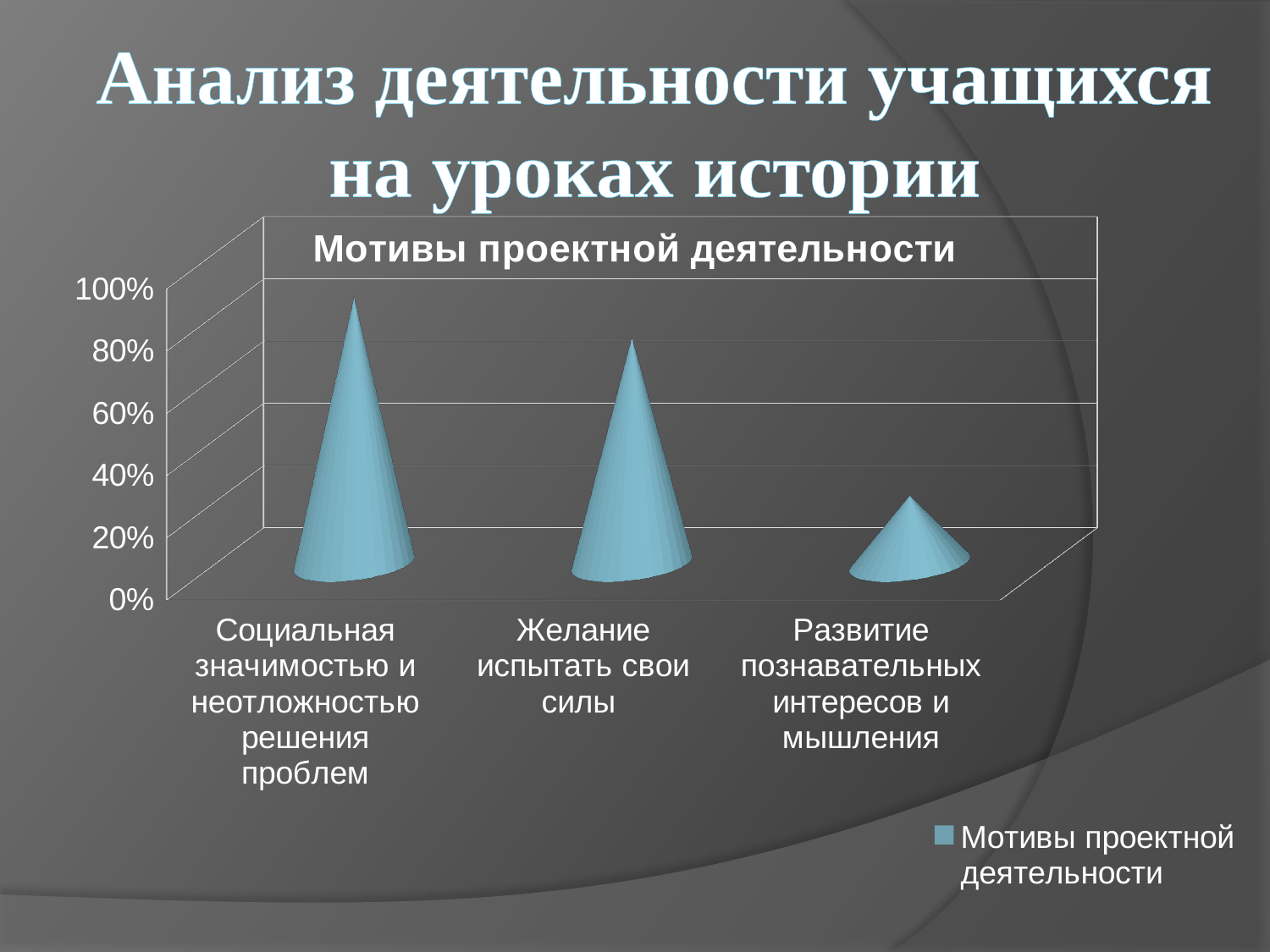
How many categories are shown on the x axis of the chart? 3 Is the value for "Желание испытать свои силы" greater or less than 60%? greater Which category has the lowest value in the chart? Развитие познавательных интересов и мышления What series name is shown in the chart legend? Мотивы проектной деятельности Is the value for "Социальная значимостью и неотложностью решения проблем" greater or less than 60%? greater How many series does the chart legend list? 1 What kind of chart is shown on the slide? Bar chart What is the title of the chart? Мотивы проектной деятельности Which is larger: the value for "Желание испытать свои силы" or the value for "Развитие познавательных интересов и мышления"? Желание испытать свои силы Do the values rise or fall from left to right along the x axis? Fall Is the value for "Развитие познавательных интересов и мышления" greater or less than 40%? less Which category has the highest value in the chart? Социальная значимостью и неотложностью решения проблем